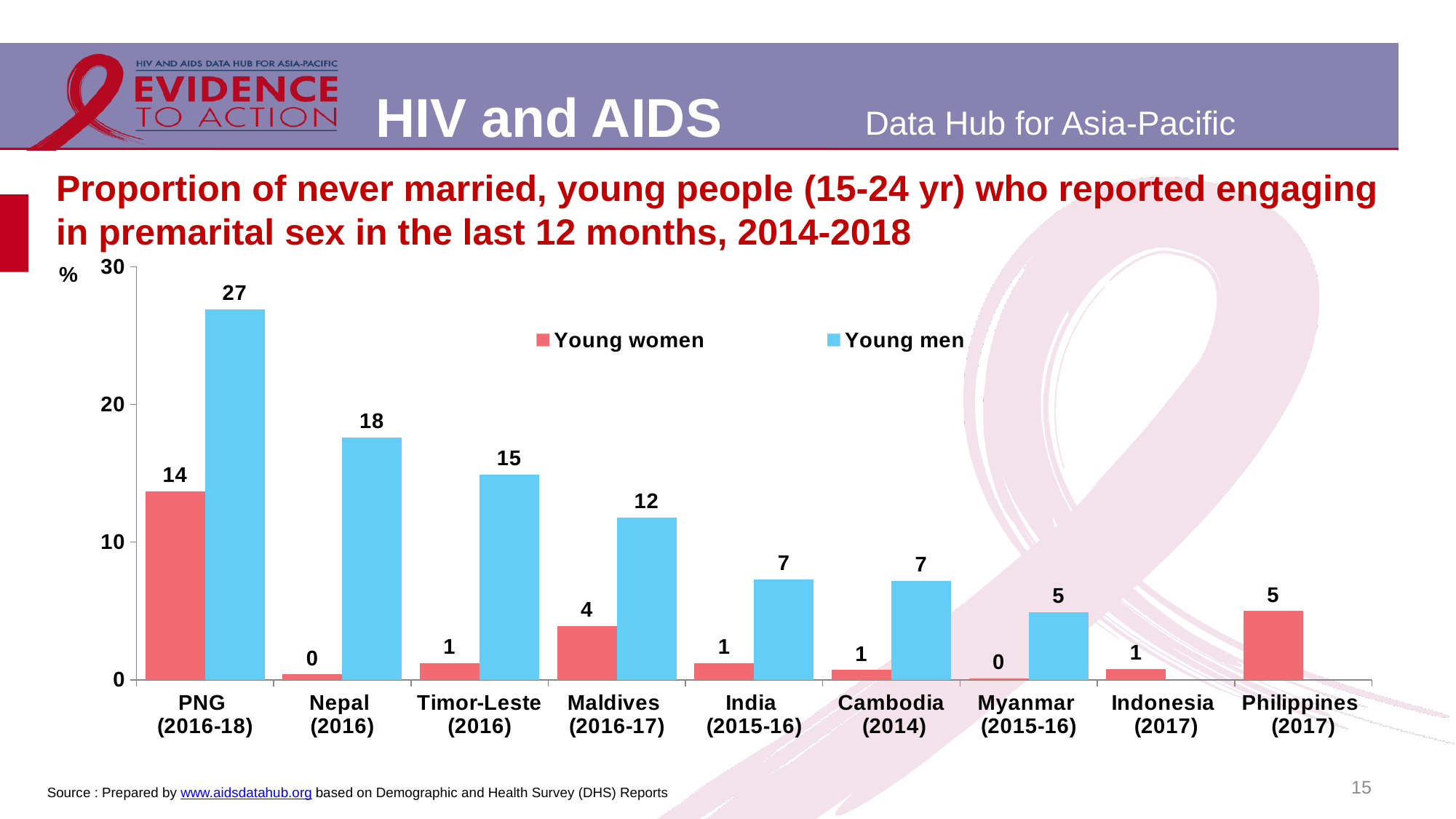
Which country has the highest value for Young women? PNG (2016-18) Which country has the highest value for Young men? PNG (2016-18) How many series does the legend list? 2 What is the value for Young women in Maldives (2016-17)? 4 Is the value for Young men in Nepal (2016) greater or less than 20? less What kind of chart is shown on the slide? Bar chart Which is larger: the Young men value for Maldives (2016-17) or the Young men value for India (2015-16)? Maldives (2016-17) How many countries are shown on the x axis? 9 What is the value for Young women in Philippines (2017)? 5 What is the difference between the Young men and Young women values for Timor-Leste (2016)? 14 What is the value for Young men in Nepal (2016)? 18 What is the value for Young men in PNG (2016-18)? 27